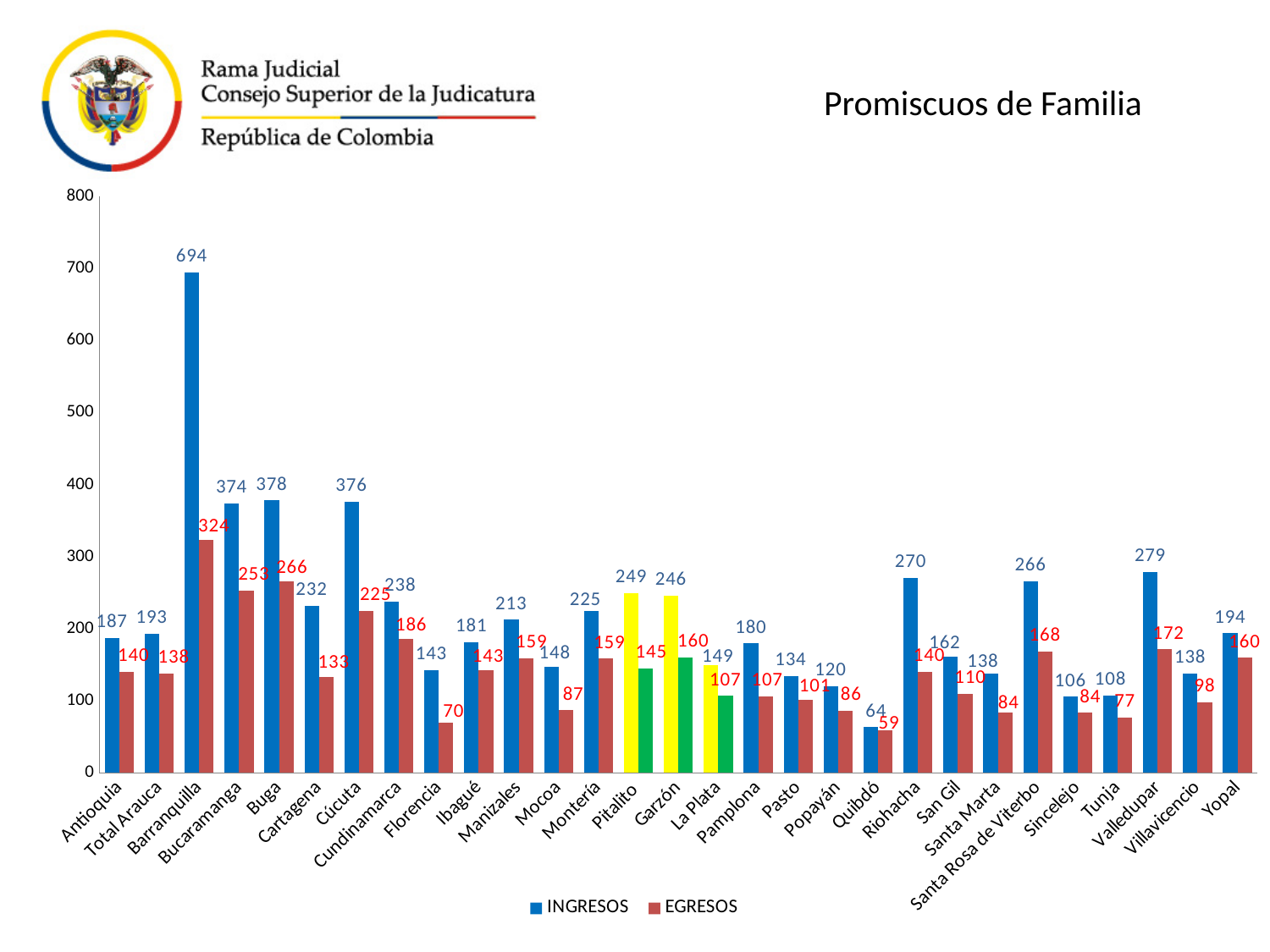
What is the INGRESOS value for Cúcuta? 376 Which category has the highest INGRESOS value? Barranquilla What is the title of the chart? Promiscuos de Familia How many categories are shown on the x axis? 29 Which has the larger INGRESOS value, Valledupar or Riohacha? Valledupar Which category has the lowest EGRESOS value? Quibdó What is the difference between INGRESOS and EGRESOS for Barranquilla? 370 Which category has the lowest INGRESOS value? Quibdó How many series does the legend list? 2 What is the EGRESOS value for Florencia? 70 What kind of chart is shown on the slide? Bar chart What is the EGRESOS value for Santa Rosa de Viterbo? 168